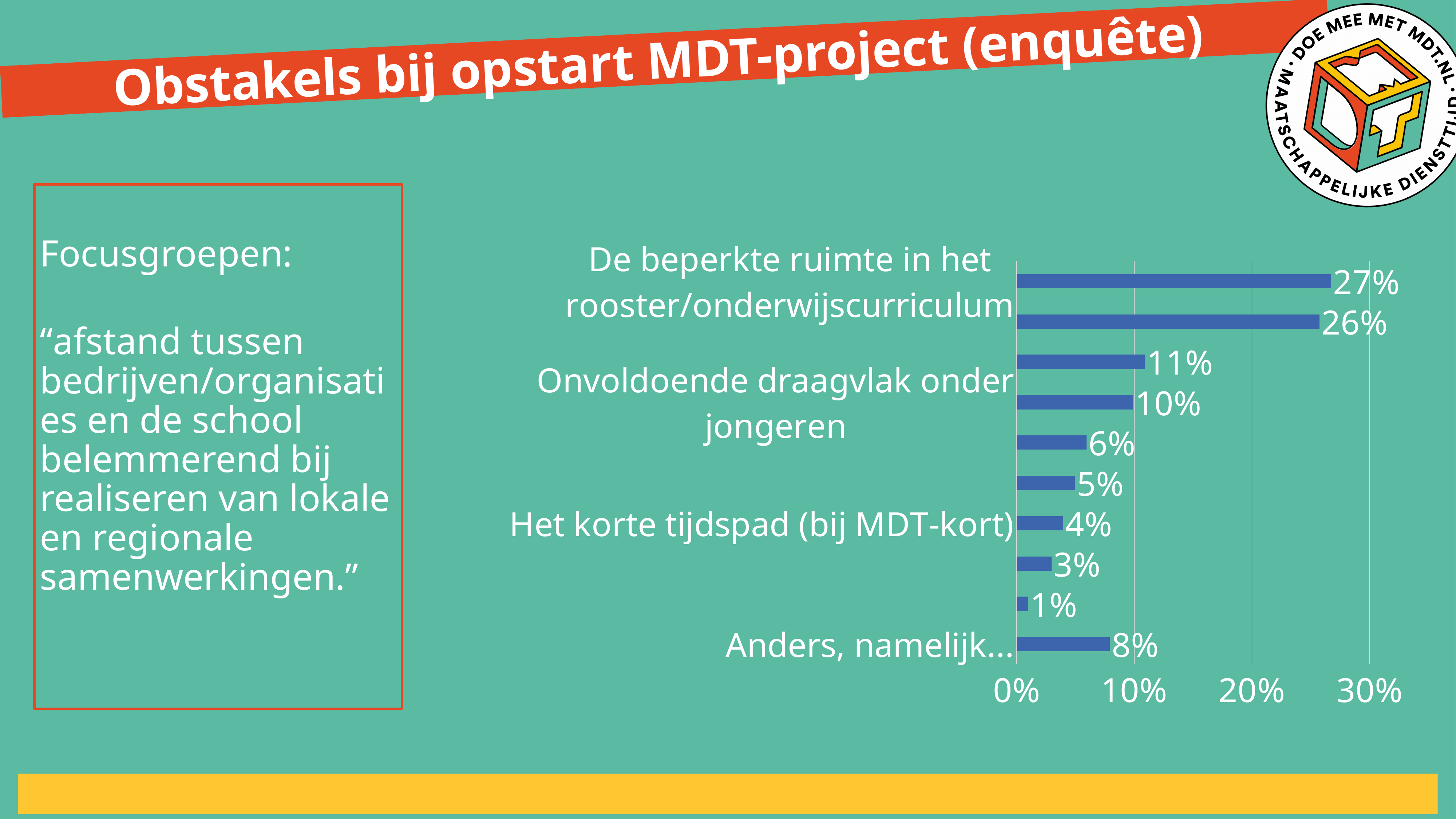
What is the title of the slide containing the chart? Obstakels bij opstart MDT-project (enquête) What kind of chart is shown on the slide? bar chart What is the value for "Het korte tijdspad (bij MDT-kort)"? 4% What is the lowest value shown by any bar in the chart? 1% Which is larger: the value for "Anders, namelijk..." or the value for "Het korte tijdspad (bij MDT-kort)"? Anders, namelijk... Which labelled category has the highest value in the chart? De beperkte ruimte in het rooster/onderwijscurriculum What is the difference between the values for "De beperkte ruimte in het rooster/onderwijscurriculum" and "Onvoldoende draagvlak onder jongeren"? 17% What is the value for "Anders, namelijk..."? 8% How many bars are plotted in the chart? 10 What is the value for "Onvoldoende draagvlak onder jongeren"? 10% What is the difference between the values for "Anders, namelijk..." and "Het korte tijdspad (bij MDT-kort)"? 4% What is the value for "De beperkte ruimte in het rooster/onderwijscurriculum"? 27%